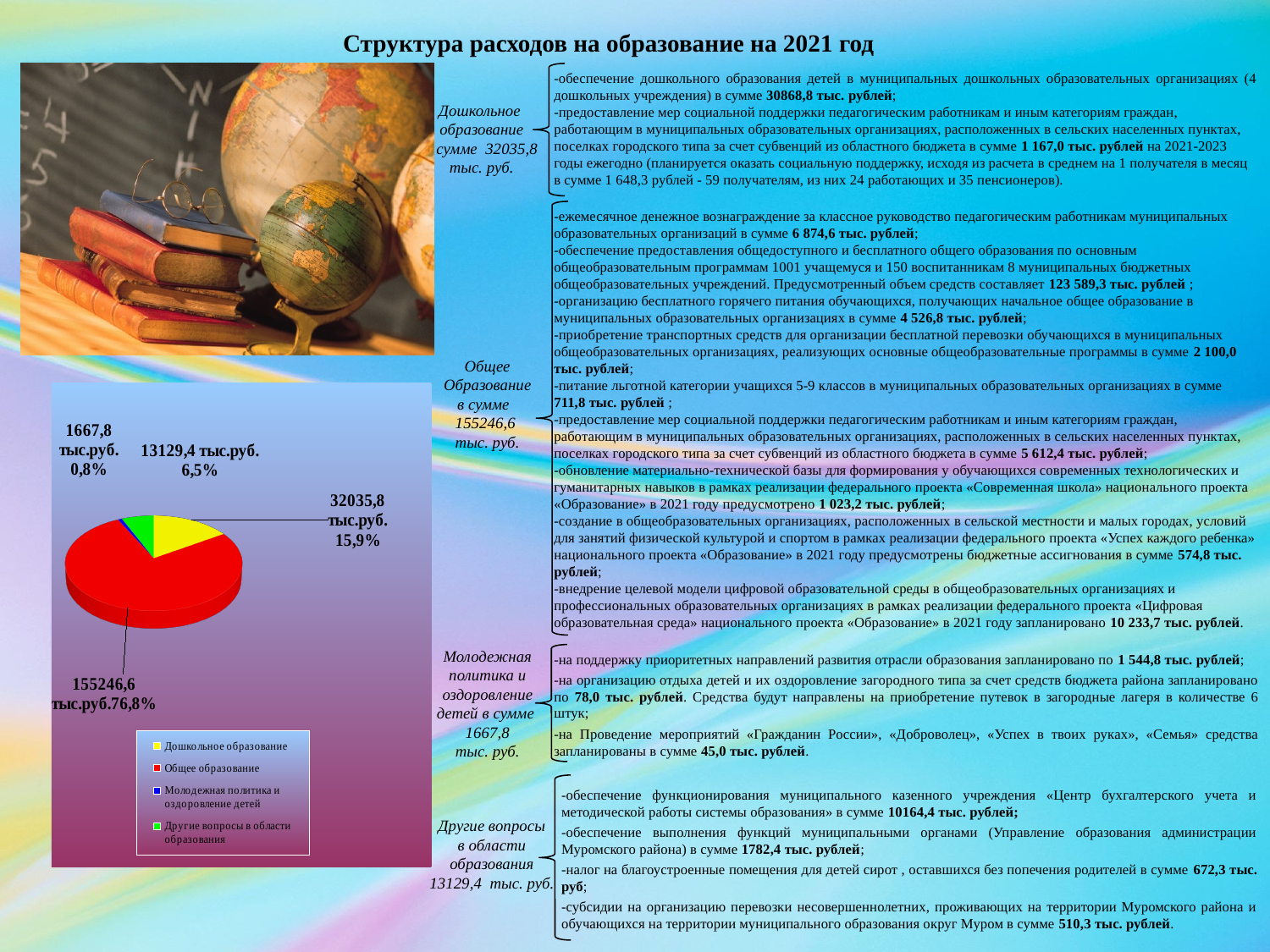
What is the difference between the values for Общее образование and Дошкольное образование in the pie chart? 123210,8 тыс.руб. What kind of chart is shown on the slide? Pie chart How many slices does the pie chart have? 4 Which is larger in the pie chart: Дошкольное образование or Другие вопросы в области образования? Дошкольное образование How many entries does the legend of the pie chart list? 4 Which category has the largest slice in the pie chart? Общее образование What value is shown for Общее образование in the pie chart? 155246,6 тыс.руб. What percentage share does Дошкольное образование have in the pie chart? 15,9% What colour is the slice for Общее образование in the pie chart? Red Which category has the smallest slice in the pie chart? Молодежная политика и оздоровление детей What percentage share does Молодежная политика и оздоровление детей have in the pie chart? 0,8% What value is shown for Другие вопросы в области образования in the pie chart? 13129,4 тыс.руб.